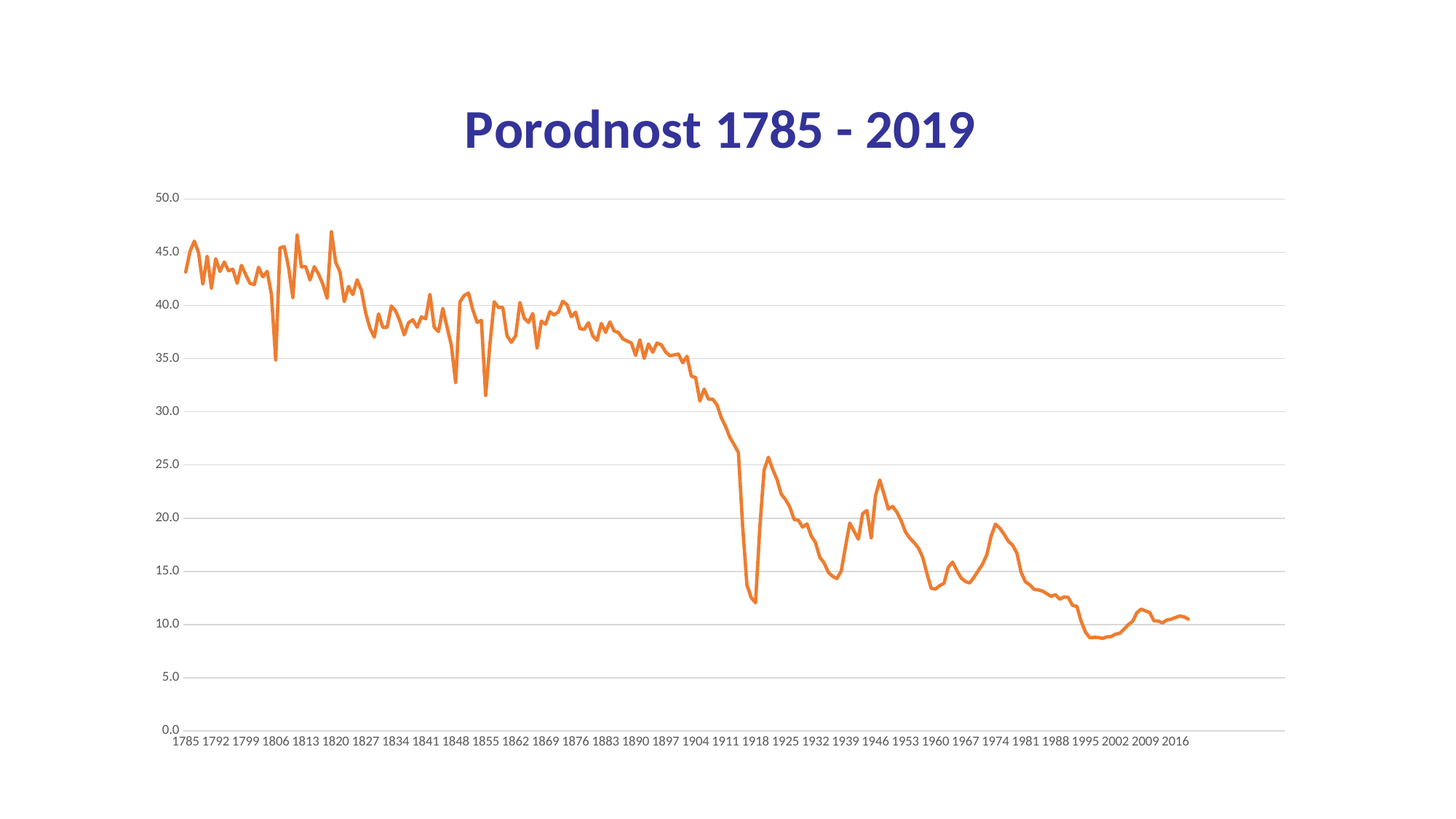
Is the value for 1918 greater or less than 15.0? less Is the value for 1911 greater or less than 30.0? less Is the value for 1946 greater or less than 20.0? greater What is the title of the chart? Porodnost 1785 - 2019 What kind of chart is shown on the slide? line chart Which year has the larger value, 1785 or 2016? 1785 What colour is the line in the chart? orange Overall, do the values rise or fall from 1785 to 2019? fall